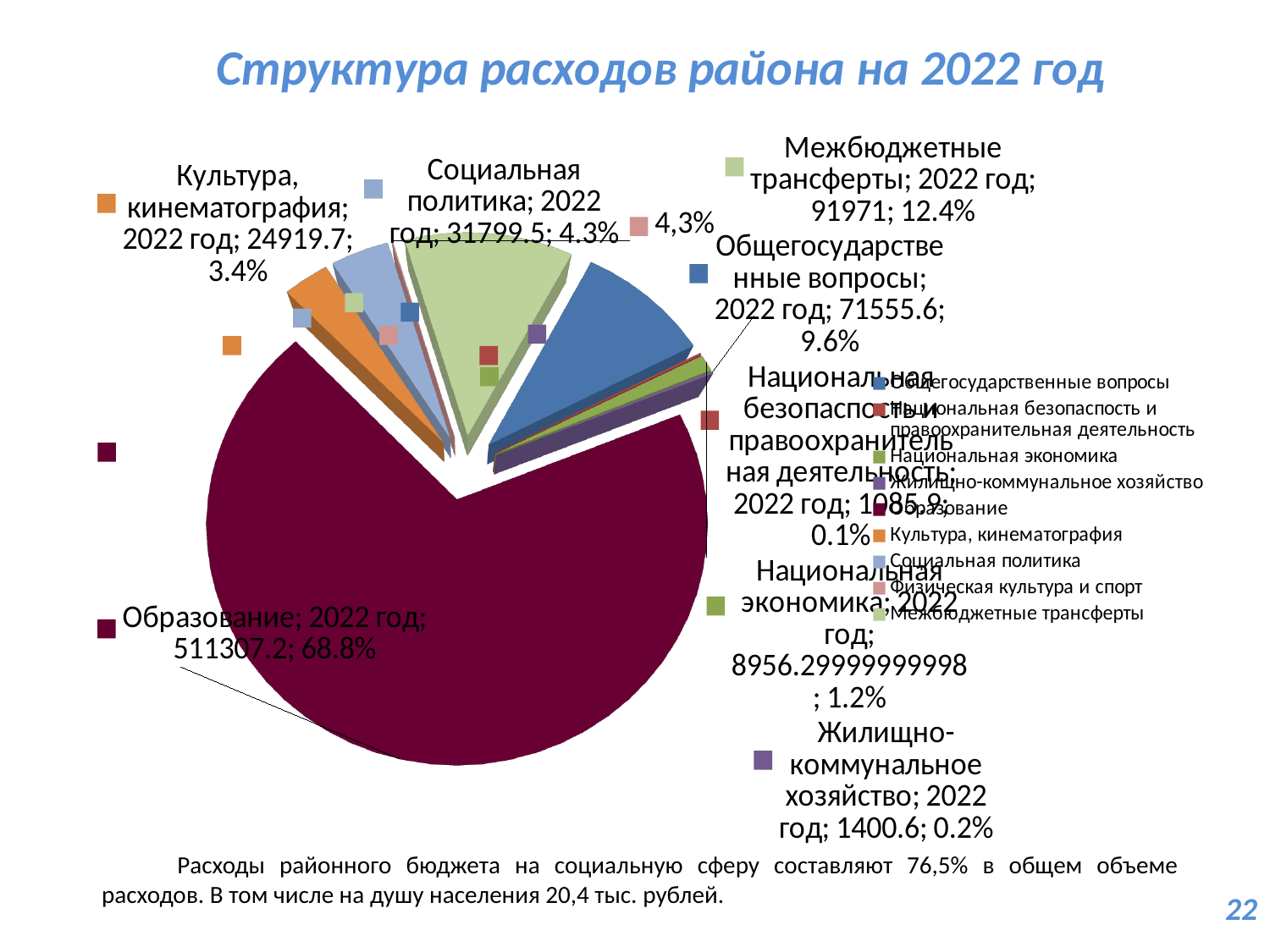
What is the value shown for Межбюджетные трансферты? 91971 What share of the pie does Культура, кинематография take? 3.4% What is the value shown for Социальная политика? 31799.5 Which category has the largest slice of the pie? Образование What share of the pie does Общегосударственные вопросы take? 9.6% What share of the pie does Образование take? 68.8% What kind of chart is shown on the slide? pie chart How many entries does the chart legend list? 9 Which is larger, the value for Межбюджетные трансферты or the value for Общегосударственные вопросы? Межбюджетные трансферты What is the title of the chart? Структура расходов района на 2022 год What is the value shown for Жилищно-коммунальное хозяйство? 1400.6 What is the value shown for Образование? 511307.2